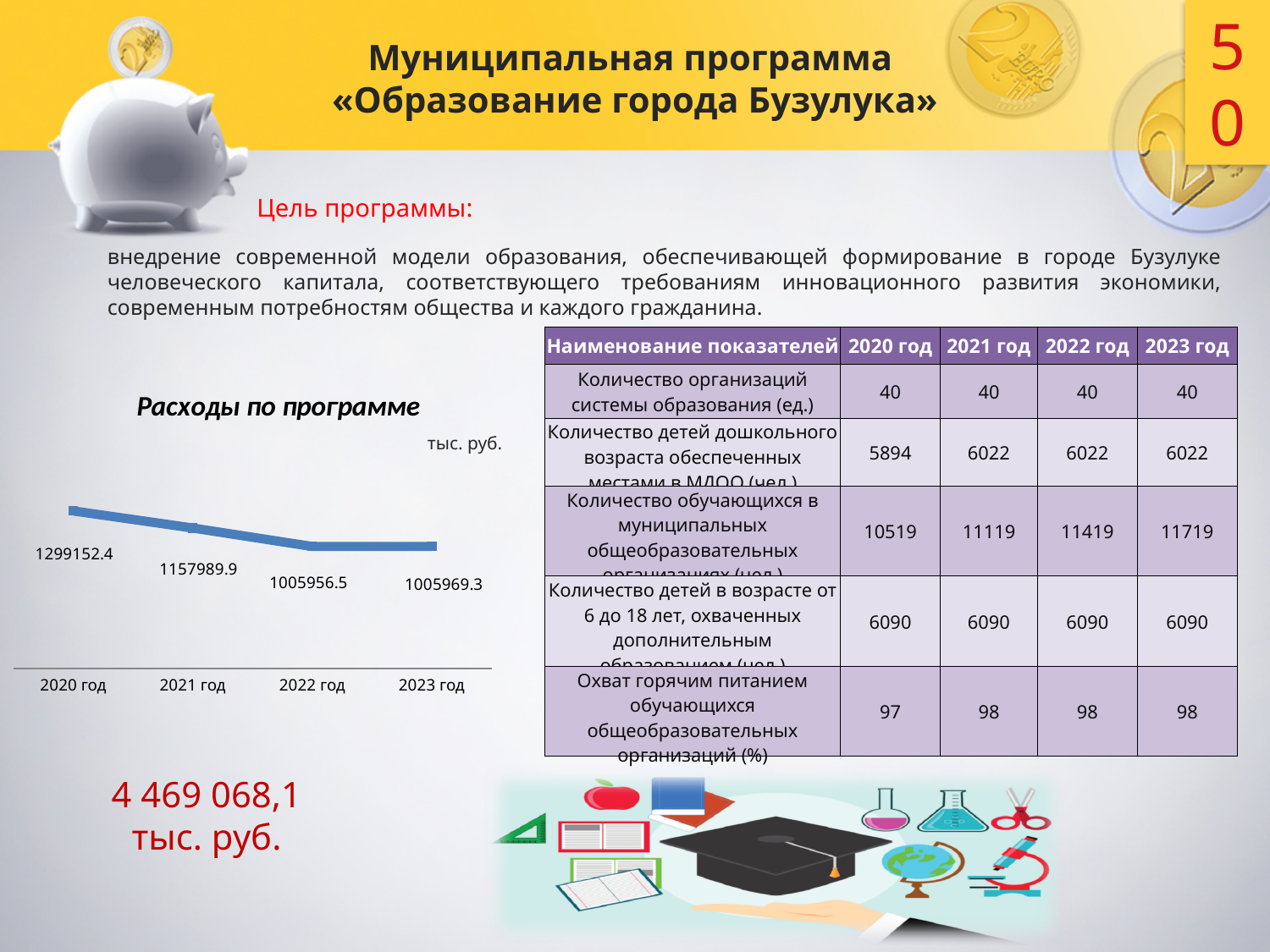
In the chart "Расходы по программе", what unit is shown for the values? тыс. руб. In the chart "Расходы по программе", what is the value for 2023 год? 1005969.3 In the chart "Расходы по программе", what is the value for 2020 год? 1299152.4 In the chart "Расходы по программе", which year has the highest value? 2020 год In the chart "Расходы по программе", what is the value for 2022 год? 1005956.5 How many years are plotted in the chart "Расходы по программе"? 4 In the chart "Расходы по программе", which is larger: the value for 2020 год or the value for 2022 год? 2020 год What type of chart is "Расходы по программе"? line chart In the chart "Расходы по программе", which year has the lowest value? 2022 год In the chart "Расходы по программе", what is the difference between the values for 2023 год and 2022 год? 12.8 In the chart "Расходы по программе", what is the difference between the values for 2020 год and 2021 год? 141162.5 In the chart "Расходы по программе", what is the value for 2021 год? 1157989.9